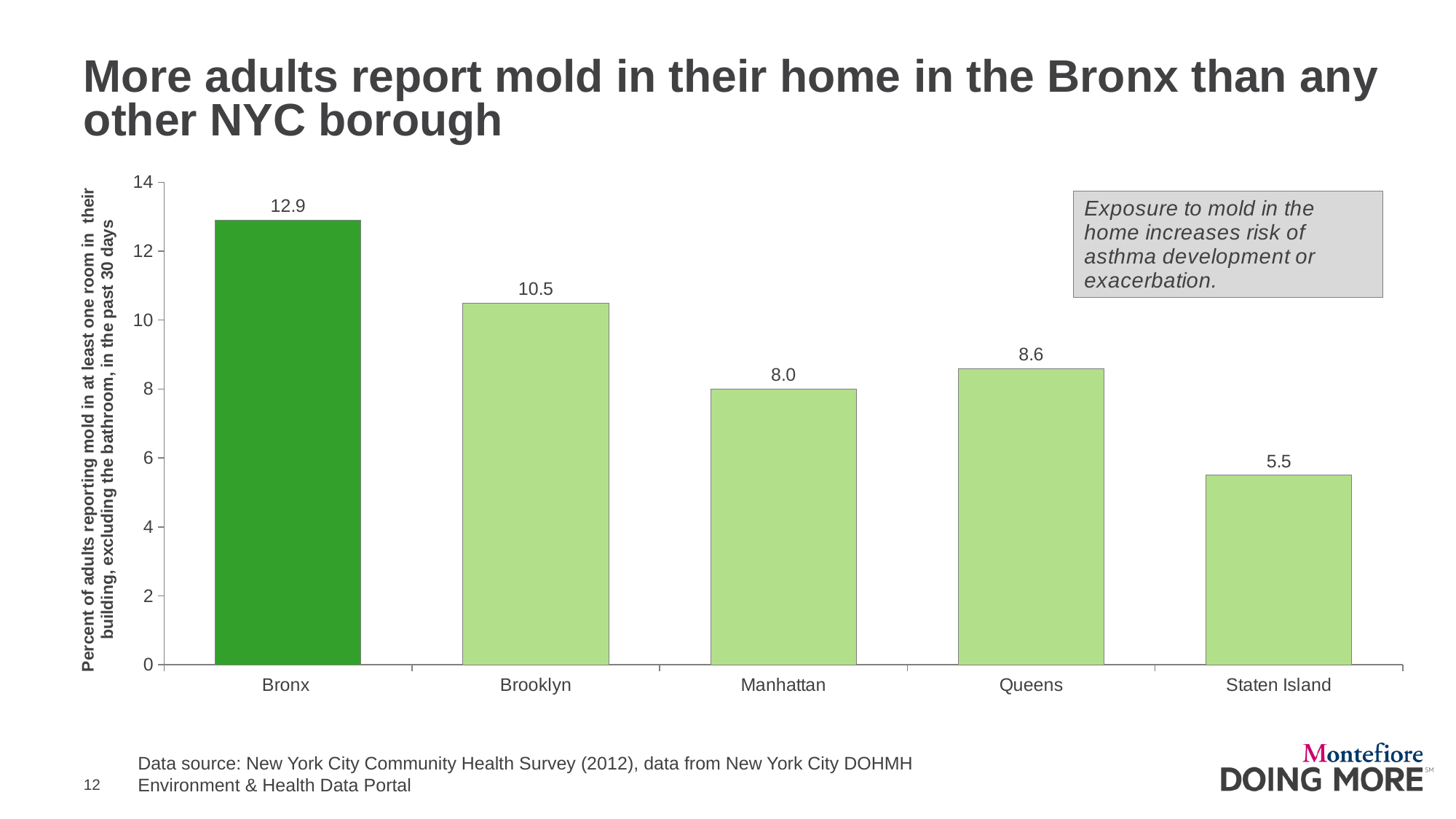
What is the difference between the values for Queens and Manhattan? 0.6 Which borough has the lowest percent of adults reporting mold? Staten Island Which borough has the highest percent of adults reporting mold? Bronx What is the difference between the values for the Bronx and Staten Island? 7.4 How many boroughs are shown on the chart? 5 What percent of adults in the Bronx report mold in at least one room in their building? 12.9 Is the value for Manhattan greater or less than 10? less Which has a higher value, Brooklyn or Queens? Brooklyn What is the value shown for Staten Island? 5.5 What kind of chart is shown on the slide? bar chart Which bar is shaded a darker green than the others? Bronx What is the value shown for Brooklyn? 10.5